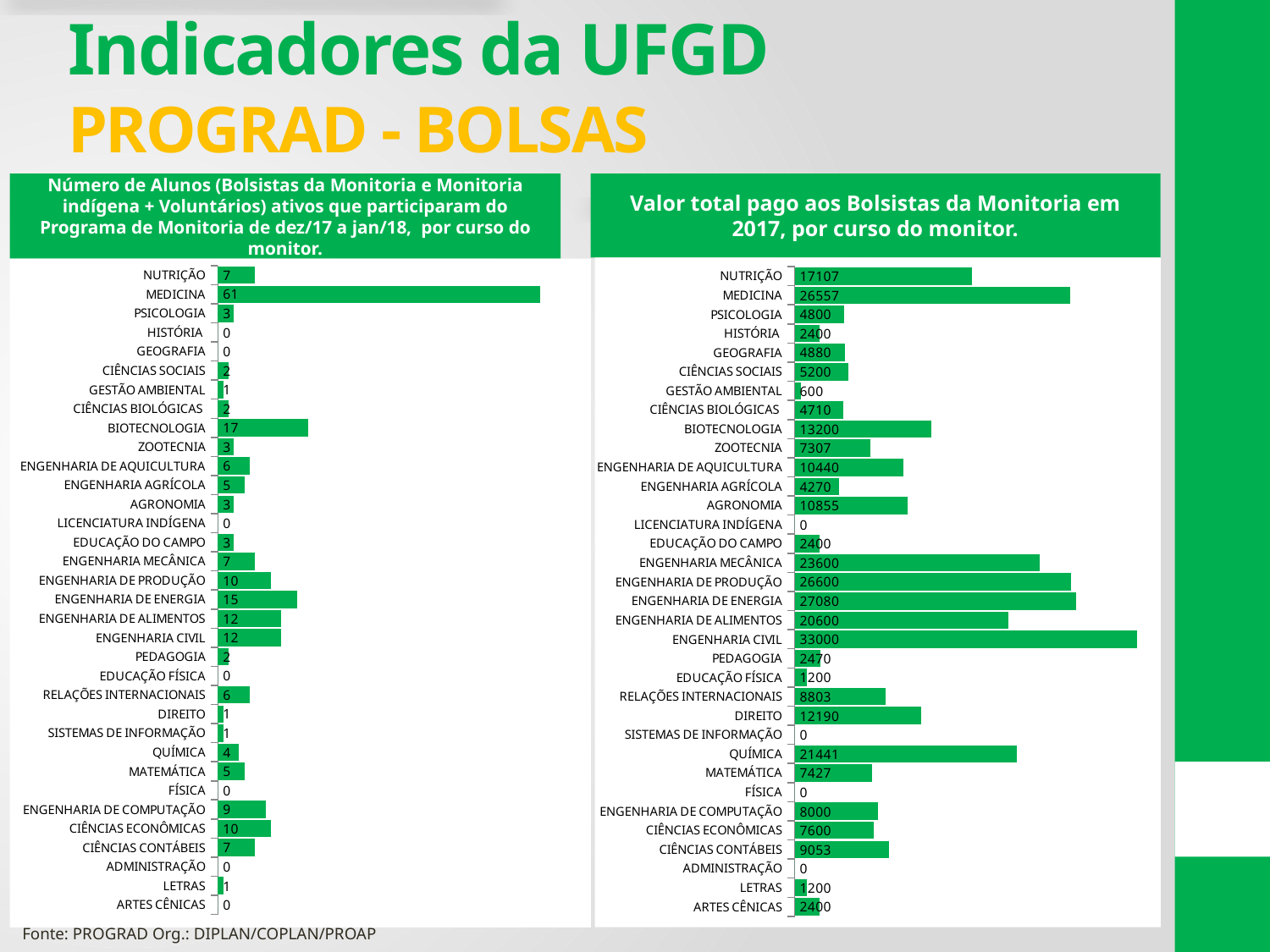
In the left chart (Número de Alunos ... por curso do monitor), which is larger, ENGENHARIA DE PRODUÇÃO or ENGENHARIA DE COMPUTAÇÃO? ENGENHARIA DE PRODUÇÃO In the right chart (Valor total pago aos Bolsistas da Monitoria em 2017), which course has the highest value? ENGENHARIA CIVIL How many courses are listed in the left chart (Número de Alunos ... por curso do monitor)? 34 In the left chart (Número de Alunos ... por curso do monitor), what is the value for BIOTECNOLOGIA? 17 In the left chart (Número de Alunos ... por curso do monitor), which course has the highest number of students? MEDICINA In the left chart (Número de Alunos ... por curso do monitor), what is the difference between ENGENHARIA DE ENERGIA and ENGENHARIA CIVIL? 3 In the right chart (Valor total pago aos Bolsistas da Monitoria em 2017), what is the difference between MEDICINA and NUTRIÇÃO? 9450 In the right chart (Valor total pago aos Bolsistas da Monitoria em 2017), what is the value for QUÍMICA? 21441 In the right chart (Valor total pago aos Bolsistas da Monitoria em 2017), what is the value for ENGENHARIA CIVIL? 33000 In the left chart (Número de Alunos ... por curso do monitor), how many students are shown for MEDICINA? 61 What type of chart is the right chart (Valor total pago aos Bolsistas da Monitoria em 2017)? Bar chart In the right chart (Valor total pago aos Bolsistas da Monitoria em 2017), which is larger, ENGENHARIA DE ENERGIA or ENGENHARIA MECÂNICA? ENGENHARIA DE ENERGIA